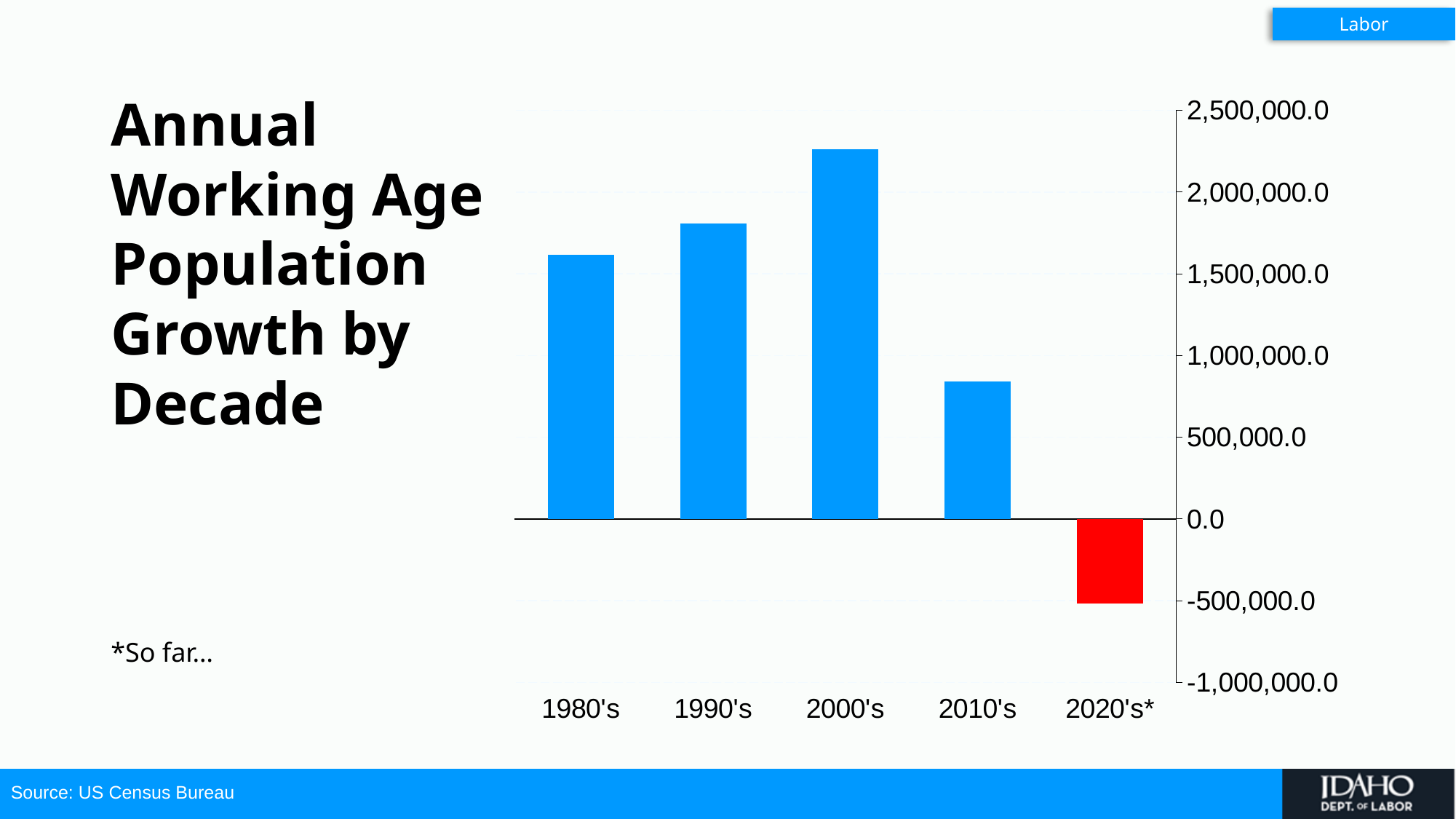
Is the value for the 1990's greater or less than 2,000,000.0? less Is the value for the 2010's greater or less than 1,000,000.0? less Is the value for the 2020's* greater or less than 0.0? less Which decade has the lowest annual working age population growth? 2020's* Do the values rise or fall from the 2000's to the 2020's*? fall Which decade has the highest annual working age population growth? 2000's What kind of chart is shown on the slide? bar chart What colour is the bar for the 2020's*? red How many decades are plotted on the chart? 5 Which is larger, the value for the 1980's or the value for the 1990's? 1990's